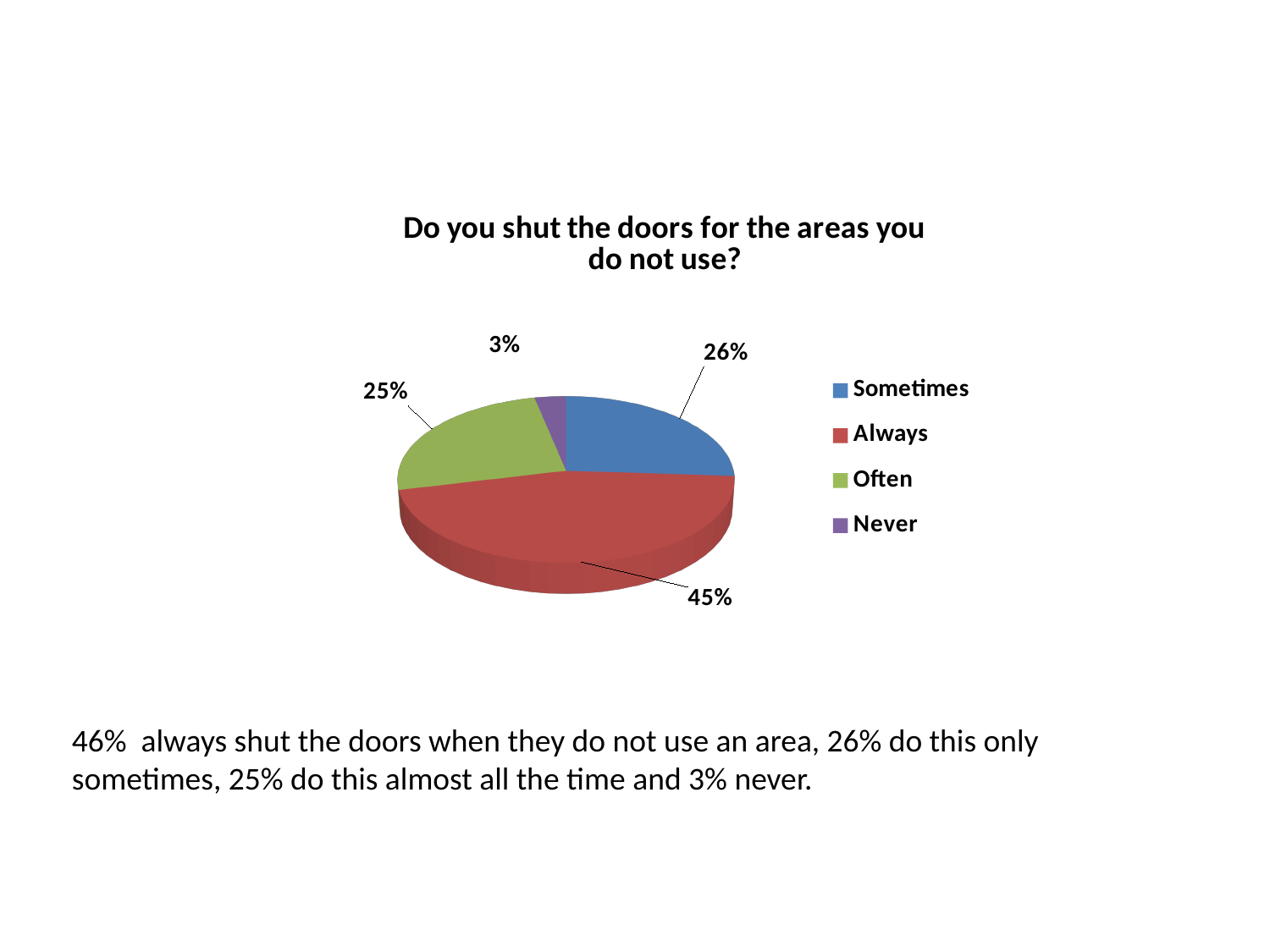
What is the chart's title? Do you shut the doors for the areas you do not use? What percentage of respondents answered "Never"? 3% What is the difference in percentage points between "Always" and "Sometimes"? 19 How many categories does the legend list? 4 What colour is the "Often" slice? green What percentage of respondents answered "Often"? 25% Which response has the smallest share of the pie? Never What kind of chart is shown on the slide? pie chart Which response has the largest share of the pie? Always What percentage of respondents answered "Sometimes"? 26% What percentage of respondents answered "Always"? 45% Which is larger, the share for "Sometimes" or the share for "Never"? Sometimes